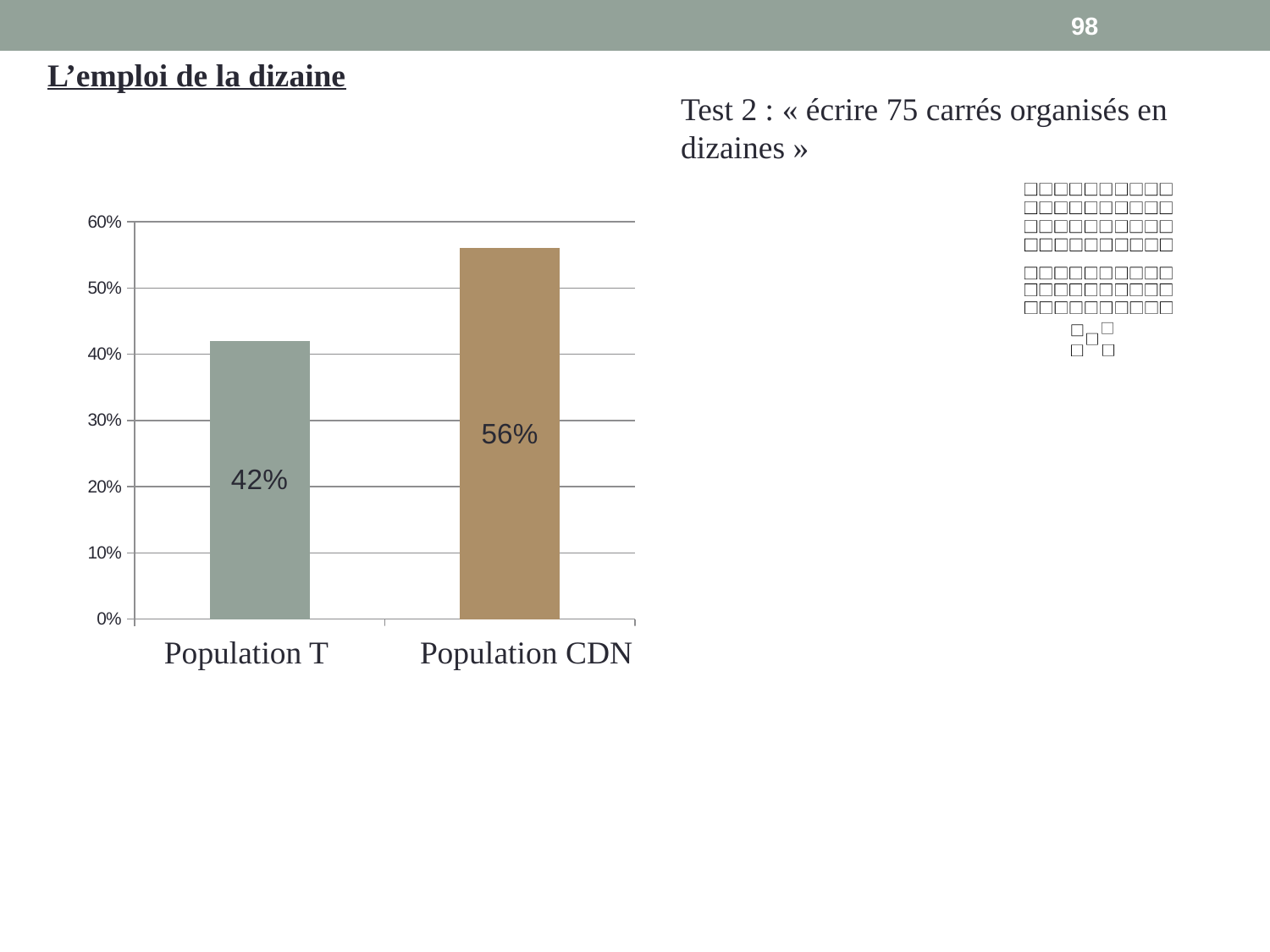
Which category has the lowest value? Population T What is the value for Population T? 42% What is the highest value shown on the y axis? 60% What is the difference between the values for Population CDN and Population T? 14% Is the value for Population CDN greater or less than 50%? greater Is the value for Population T greater or less than 50%? less Which category has the highest value? Population CDN What kind of chart is shown on the slide? bar chart Which is larger, the value for Population T or the value for Population CDN? Population CDN What is the value for Population CDN? 56% What is the label of the first category on the x axis? Population T How many categories are shown on the x axis? 2